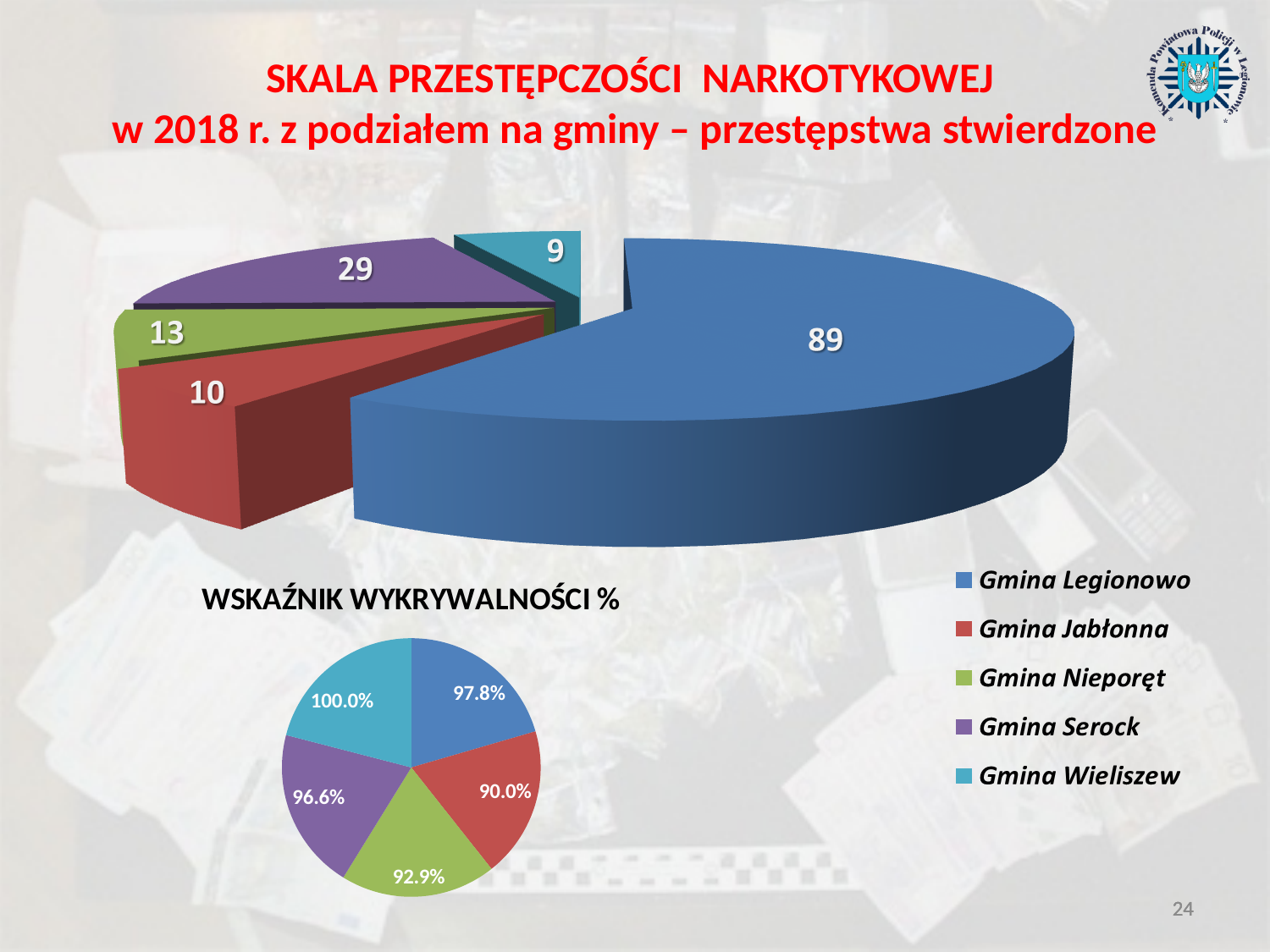
In the large pie chart at the top of the slide, what is the value for Gmina Wieliszew? 9 In the large pie chart at the top of the slide, what is the value for Gmina Legionowo? 89 How many entries does the legend on the slide list? 5 In the large pie chart at the top of the slide, which gmina has the highest value? Gmina Legionowo In the large pie chart at the top of the slide, what is the difference between the values for Gmina Legionowo and Gmina Serock? 60 In the chart titled WSKAŹNIK WYKRYWALNOŚCI %, what is the value for Gmina Jabłonna? 90.0% In the chart titled WSKAŹNIK WYKRYWALNOŚCI %, which gmina has the highest value? Gmina Wieliszew In the chart titled WSKAŹNIK WYKRYWALNOŚCI %, what is the difference between the values for Gmina Legionowo and Gmina Nieporęt? 4.9% In the large pie chart at the top of the slide, what is the total of all the slices? 150 In the large pie chart at the top of the slide, which gmina has the lowest value? Gmina Wieliszew In the large pie chart at the top of the slide, which is larger, the value for Gmina Nieporęt or Gmina Jabłonna? Gmina Nieporęt In the large pie chart at the top of the slide, what is the value for Gmina Serock? 29